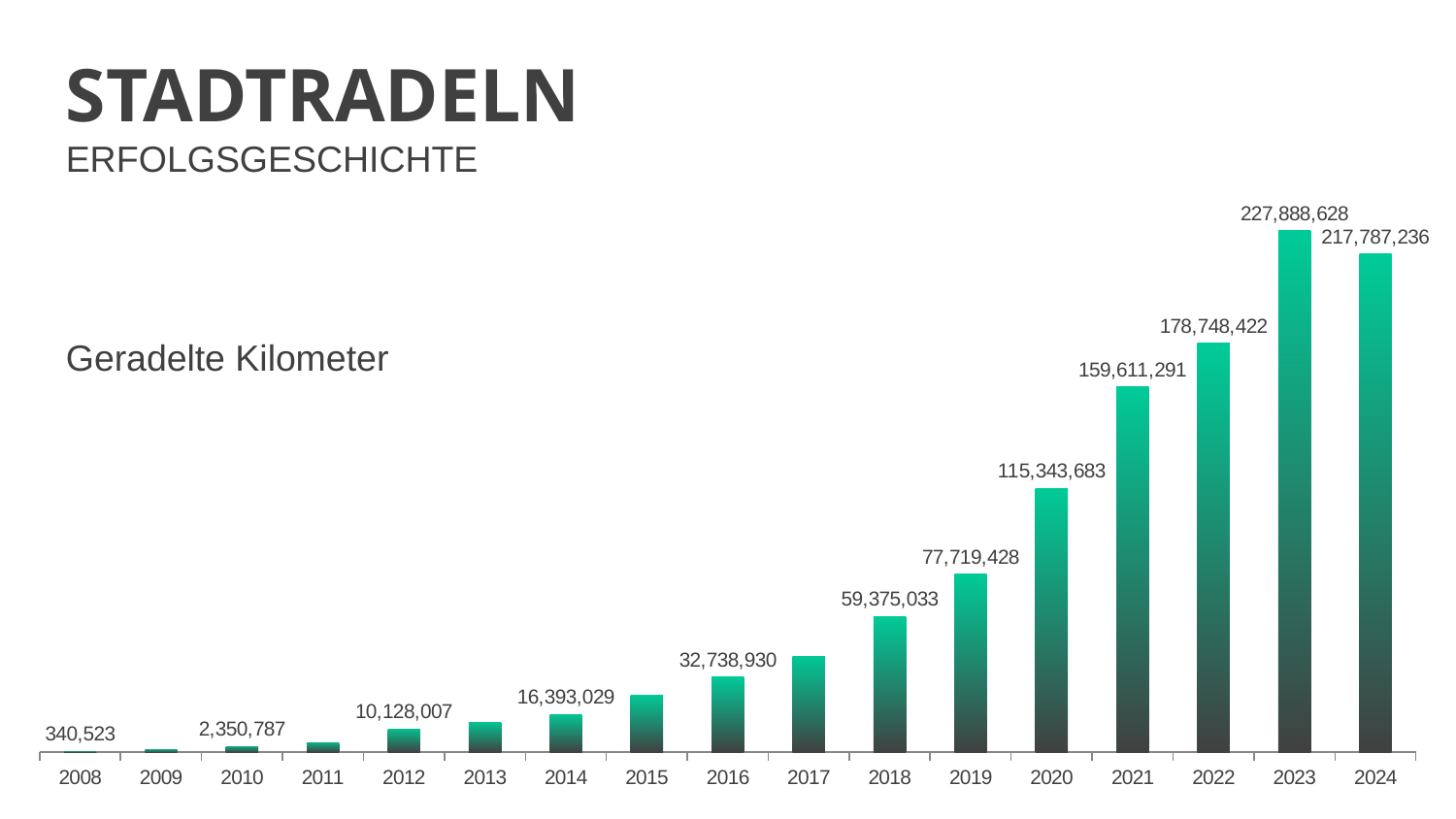
What value is shown for 2024? 217,787,236 What value is shown for 2016? 32,738,930 Which year has the highest value? 2023 Which is larger, the value for 2019 or the value for 2018? 2019 What value is shown for 2020? 115,343,683 Which year has the lowest value? 2008 What is the difference between the values for 2022 and 2021? 19,137,131 What is the difference between the values for 2023 and 2024? 10,101,392 What kind of chart is shown on the slide? Bar chart What value is shown for 2008? 340,523 What value is shown for 2023? 227,888,628 How many years are shown on the x axis? 17